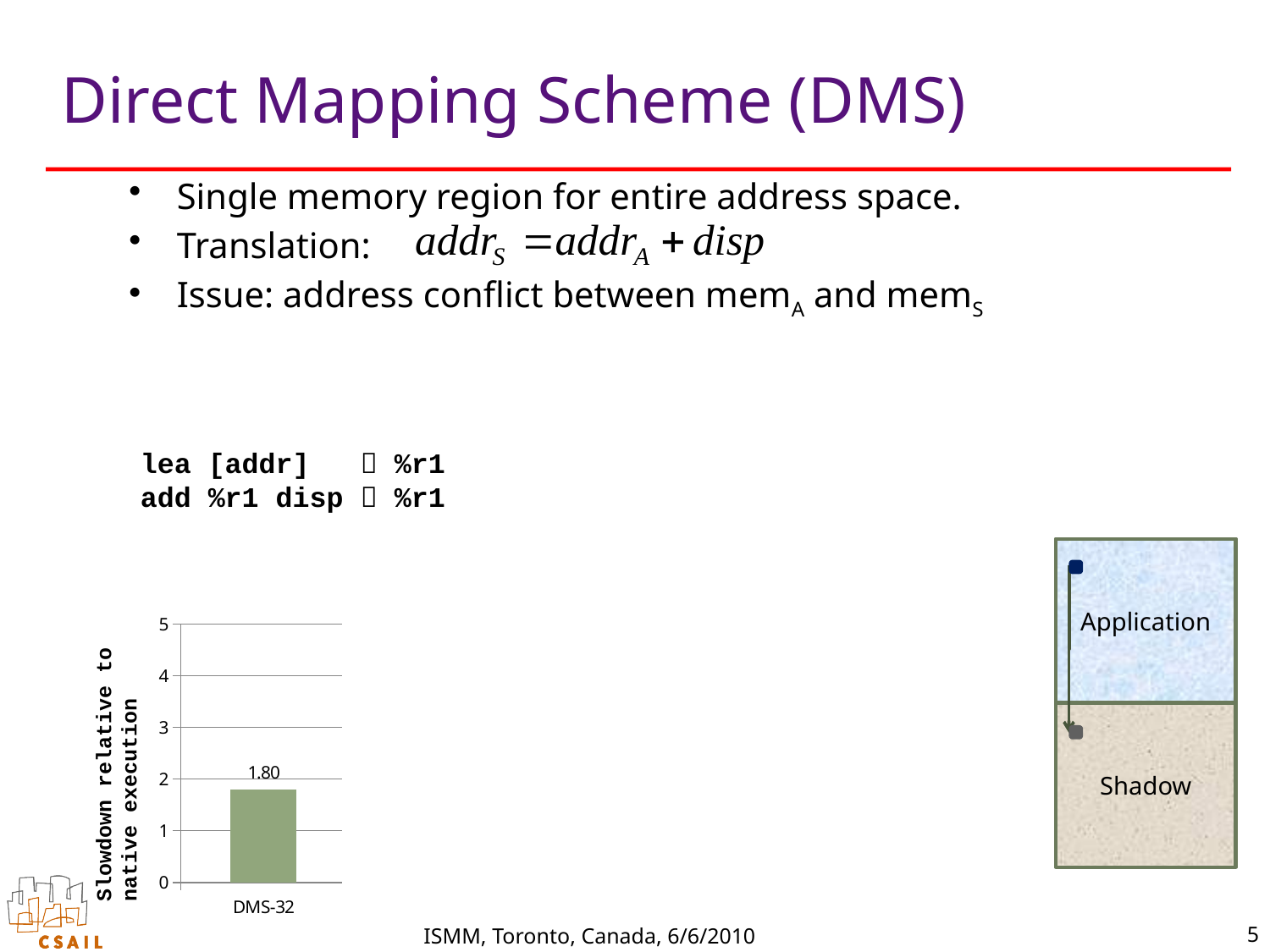
What is the label of the single bar in the chart? DMS-32 What is the slowdown value shown for DMS-32? 1.80 How many categories are plotted in the chart? 1 What is the label of the y axis of the chart? Slowdown relative to native execution Is the value for DMS-32 greater or less than 1? greater Is the value for DMS-32 greater or less than 2? less What is the maximum value shown on the y axis of the chart? 5 What kind of chart is shown on the slide? bar chart